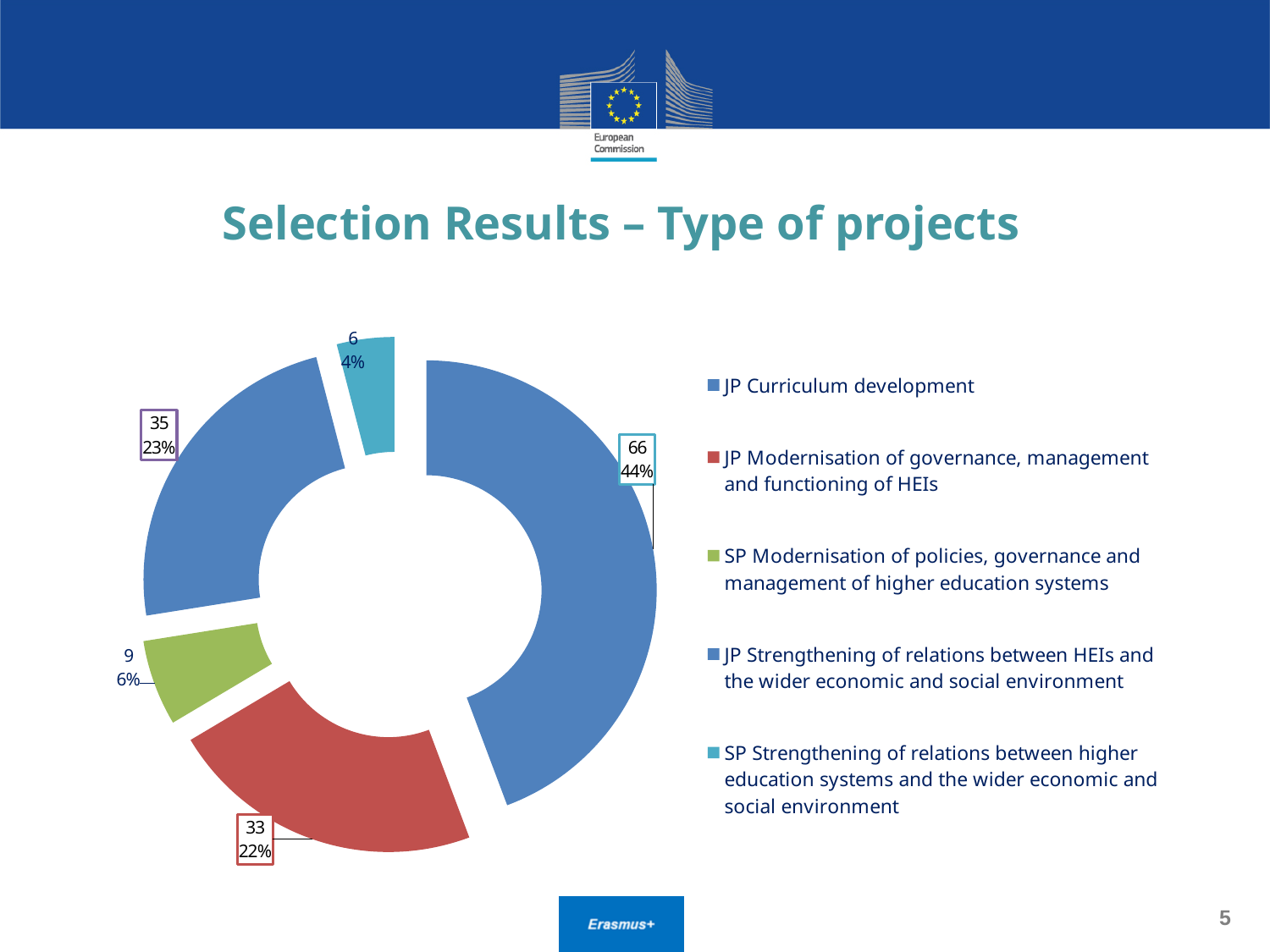
What kind of chart is shown on the slide? Doughnut (pie) chart What is the difference in the number of projects between JP Curriculum development and JP Modernisation of governance, management and functioning of HEIs? 33 How many categories does the chart show? 5 What percentage is shown for SP Strengthening of relations between higher education systems and the wider economic and social environment? 4% Which category has the smallest number of projects? SP Strengthening of relations between higher education systems and the wider economic and social environment How many projects are in the JP Modernisation of governance, management and functioning of HEIs category? 33 What is the title of the slide containing the chart? Selection Results – Type of projects How many projects are in the JP Curriculum development category? 66 What share of the chart does JP Curriculum development represent? 44% How many projects are in the JP Strengthening of relations between HEIs and the wider economic and social environment category? 35 What percentage is shown for SP Modernisation of policies, governance and management of higher education systems? 6% Which category has the largest number of projects? JP Curriculum development